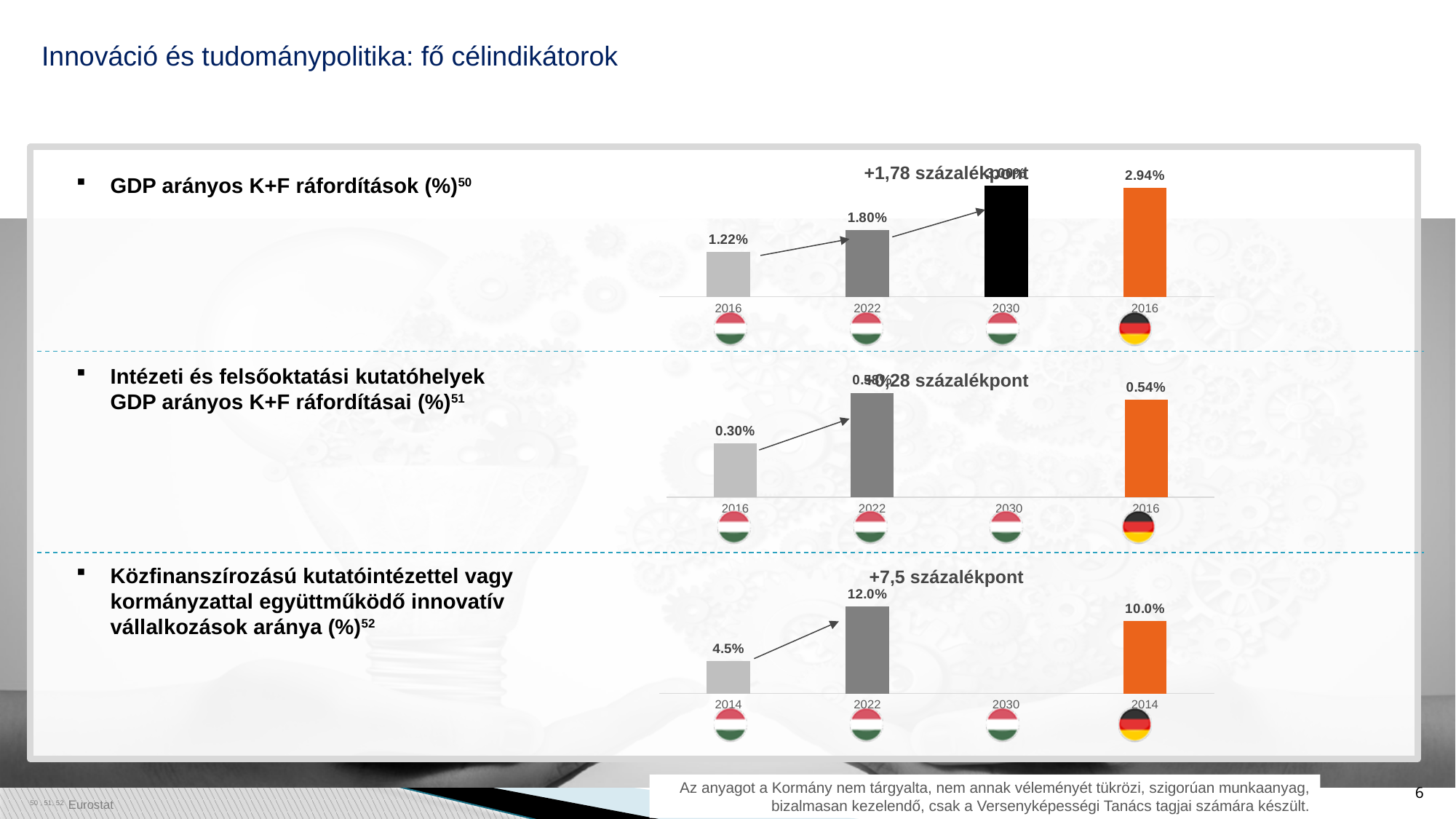
In the top chart (GDP arányos K+F ráfordítások), what is the value for Hungary in 2016? 1.22% In the top chart (GDP arányos K+F ráfordítások), which bar is the lowest? Hungary 2016 In the top chart (GDP arányos K+F ráfordítások), what is the value for Germany in 2016? 2.94% In the bottom chart (Közfinanszírozású kutatóintézettel együttműködő innovatív vállalkozások), what is the difference between the Hungarian 2022 value and the Hungarian 2014 value? 7.5 percentage points In the middle chart (Intézeti és felsőoktatási kutatóhelyek), what is the value for Germany in 2016? 0.54% In the top chart (GDP arányos K+F ráfordítások), what is the value for Hungary in 2022? 1.80% In the middle chart (Intézeti és felsőoktatási kutatóhelyek), what is the value for Hungary in 2016? 0.30% In the top chart (GDP arányos K+F ráfordítások), how many bars are plotted? 4 In the top chart (GDP arányos K+F ráfordítások), what is the difference between the Hungarian 2022 value and the Hungarian 2016 value? 0.58 percentage points In the bottom chart (Közfinanszírozású kutatóintézettel együttműködő innovatív vállalkozások), what is the value for Hungary in 2022? 12.0% In the middle chart (Intézeti és felsőoktatási kutatóhelyek), which is larger: the Hungarian 2016 value or the German 2016 value? German 2016 What kind of chart is the bottom chart (Közfinanszírozású kutatóintézettel együttműködő innovatív vállalkozások)? Bar chart